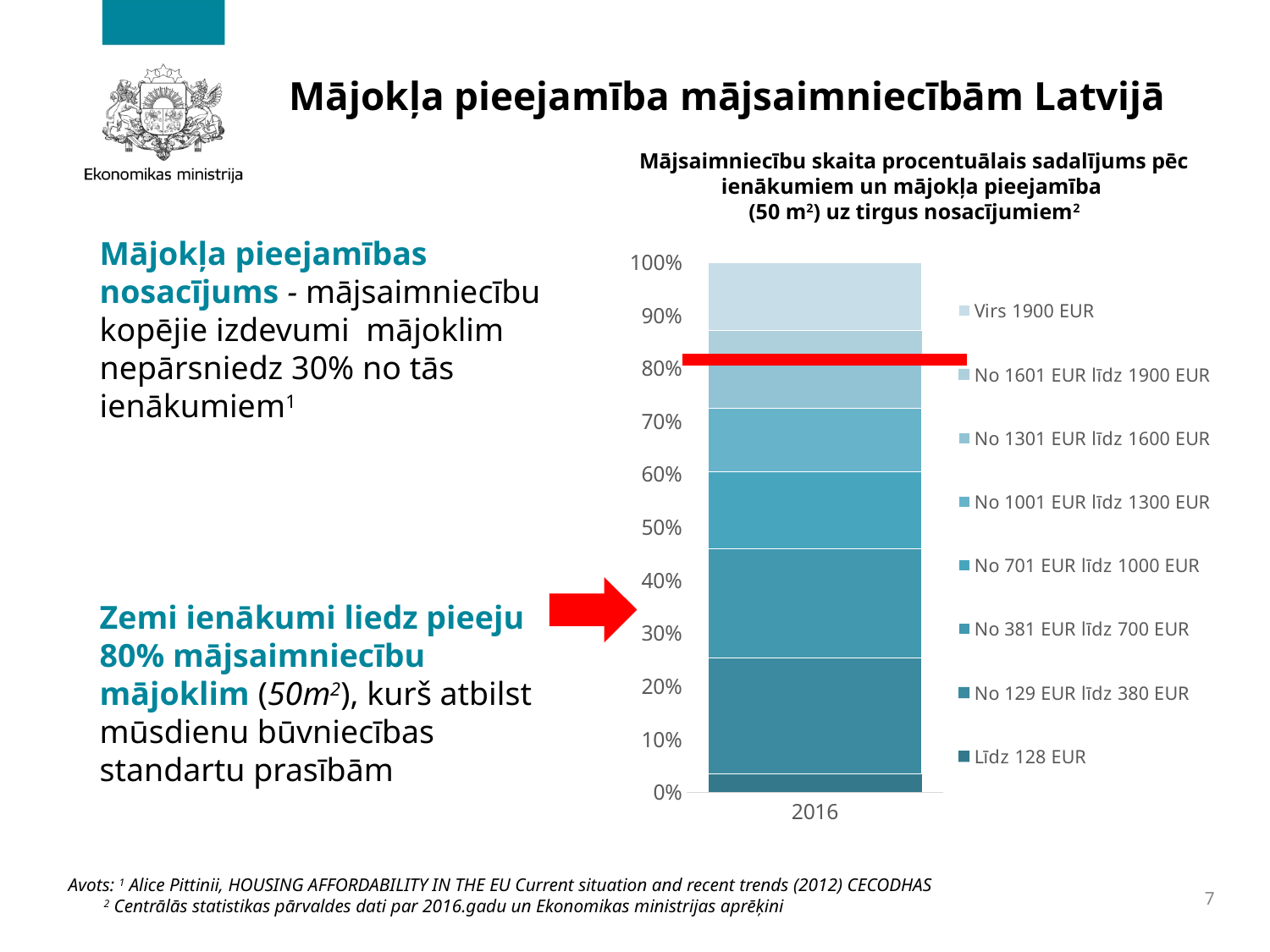
Is the value for No 129 EUR līdz 380 EUR greater or less than 10%? greater What is the total of the stacked bar for 2016? 100% Is the value for Līdz 128 EUR greater or less than 10%? less Which legend entry is listed at the top of the chart legend? Virs 1900 EUR How many series does the chart legend list? 8 Which income group has the smallest segment in the stacked bar? Līdz 128 EUR What is the category label shown on the x axis of the chart? 2016 Which segment is larger: No 129 EUR līdz 380 EUR or No 1301 EUR līdz 1600 EUR? No 129 EUR līdz 380 EUR What is the first line of the chart title? Mājsaimniecību skaita procentuālais sadalījums pēc How many categories are plotted on the x axis of the chart? 1 Which segment is larger: Līdz 128 EUR or Virs 1900 EUR? Virs 1900 EUR What kind of chart is shown on the slide? stacked bar chart